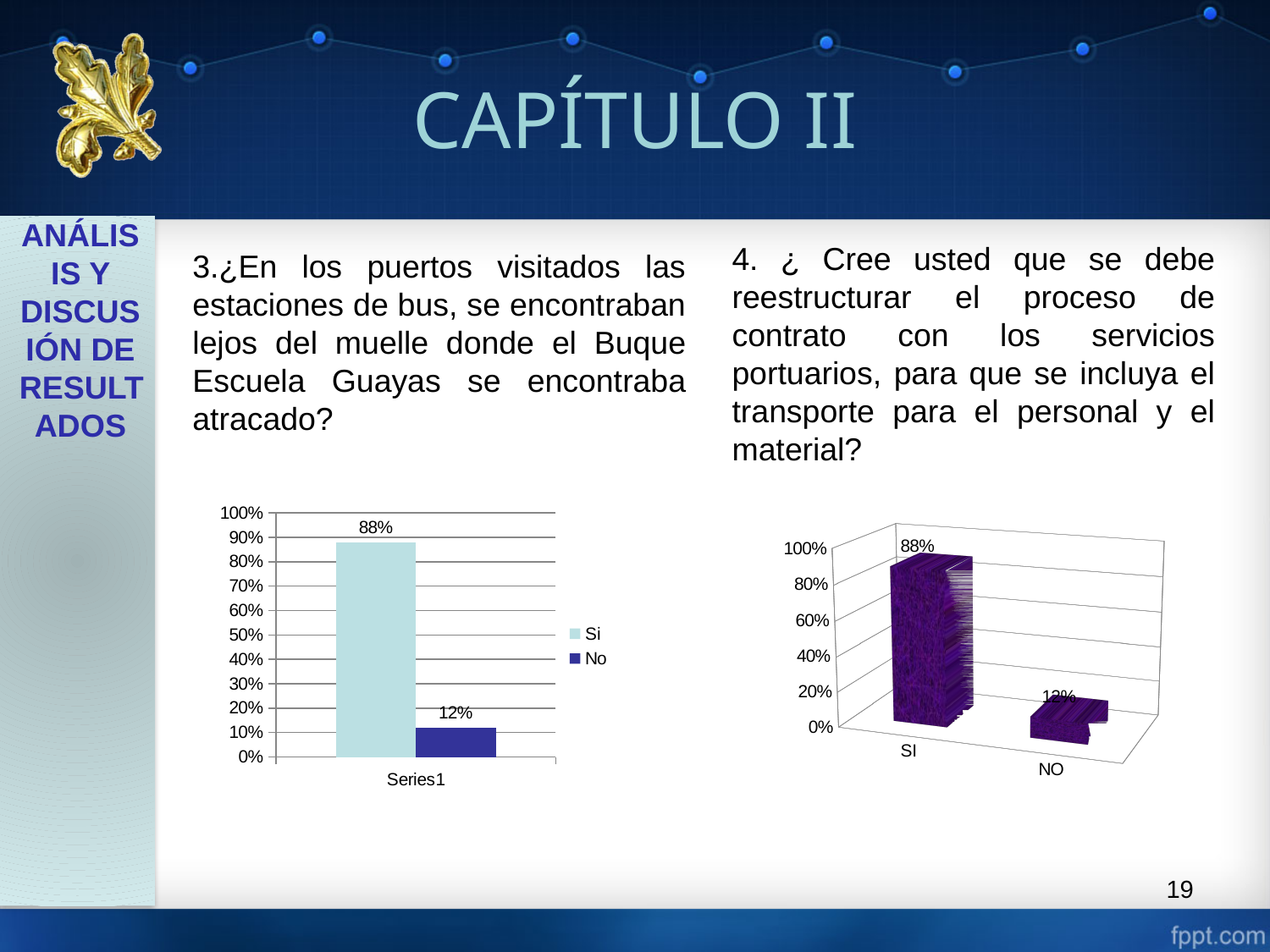
In the left chart, what is the value for No? 12% In the left chart, which series has the highest value? Si What kind of chart is the right chart? bar chart In the right chart, is the value for NO greater or less than 20%? less How many series does the legend of the left chart list? 2 In the right chart, which is larger, SI or NO? SI In the left chart, what is the difference between the Si and No values? 76% In the right chart, what is the value for SI? 88% In the left chart, what is the value for Si? 88% What is the category label shown on the x axis of the left chart? Series1 In the right chart, what is the value for NO? 12% In the right chart, which category has the lowest value? NO